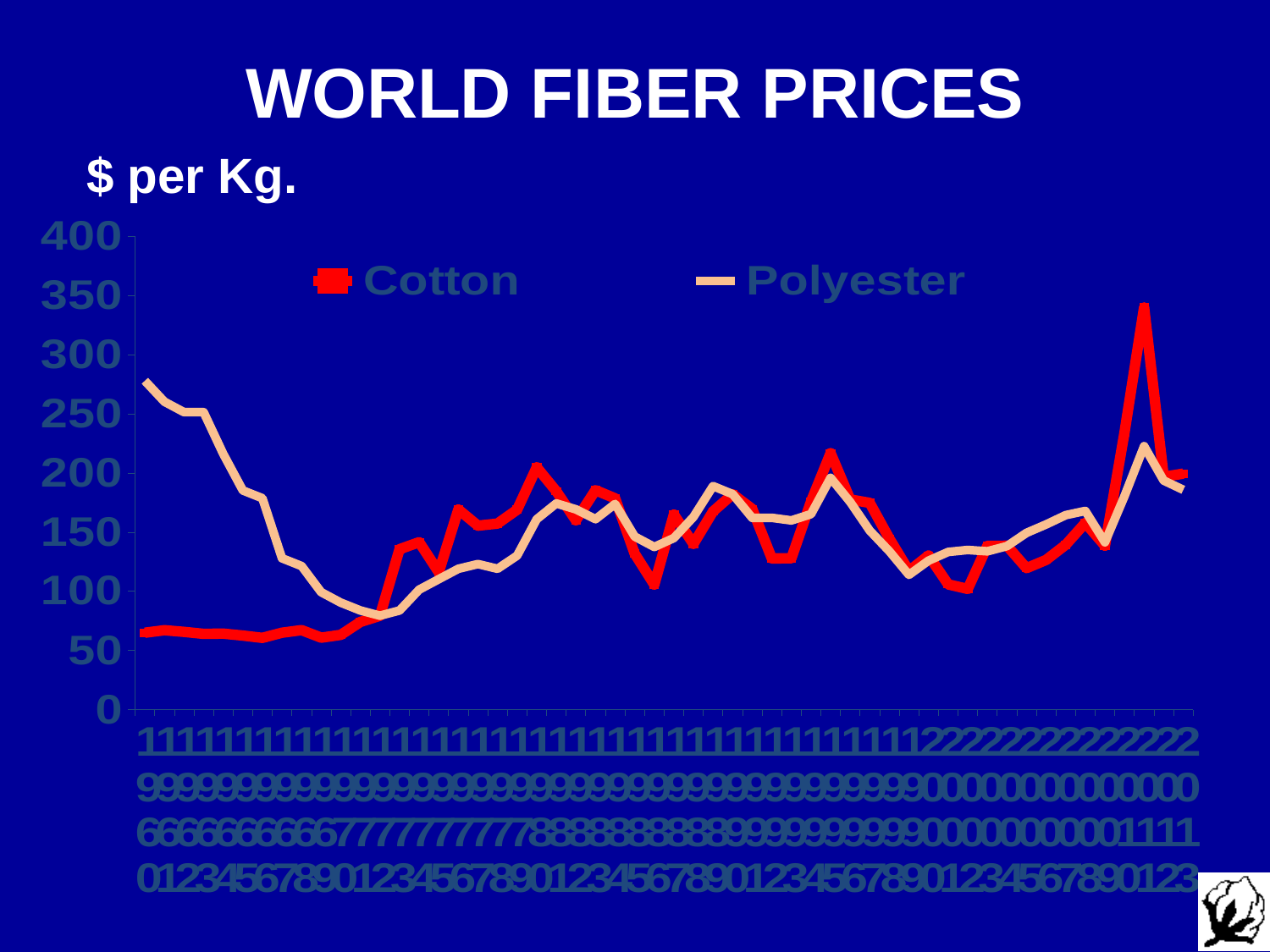
What are the two series named in the legend? Cotton and Polyester How many series does the legend list? 2 What unit is given for the prices on the chart? $ per Kg. At the first year shown (1960), is the value for Polyester greater or less than 250? greater At the first year shown (1960), is the value for Cotton greater or less than 100? less What kind of chart is shown on the slide? line chart At its highest peak (around 2011), is the value for Cotton greater or less than 300? greater At the first year shown (1960), which series has the higher value, Cotton or Polyester? Polyester Which series reaches the highest value anywhere on the chart? Cotton At the 2011 peak, which series has the higher value, Cotton or Polyester? Cotton Does the Polyester line rise or fall between 1960 and 1970? fall